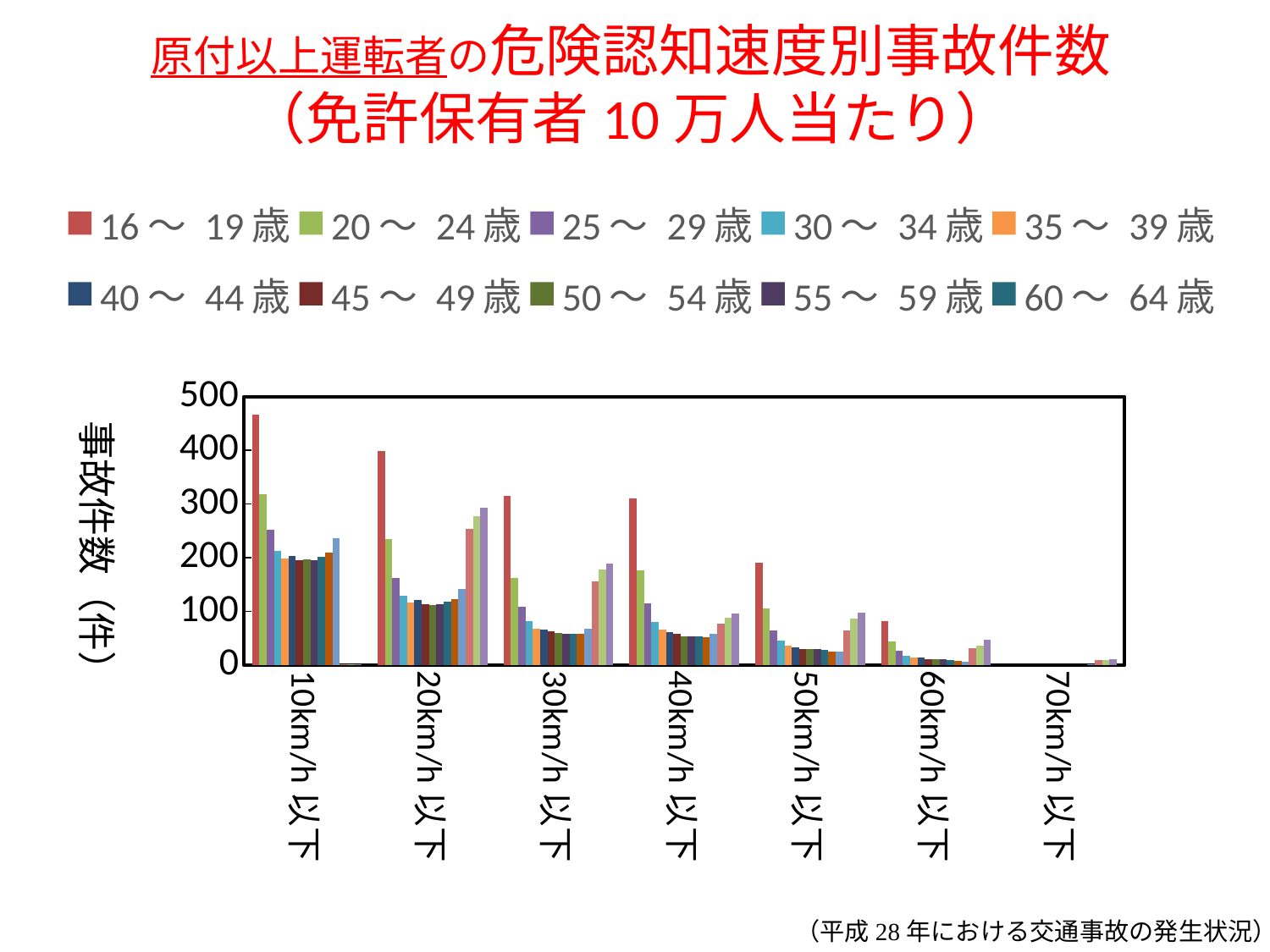
Is the value for 20～24歳 at 20km/h以下 greater or less than 200? greater Is the value for 16～19歳 at 10km/h以下 greater or less than 400? greater At 10km/h以下, which is larger: the value for 16～19歳 or for 20～24歳? 16～19歳 What kind of chart is shown on the slide? bar chart What is the label of the vertical axis? 事故件数（件） How many speed categories are shown on the x axis? 7 Is the value for 20～24歳 at 10km/h以下 greater or less than 300? greater Do the values for the 16～19歳 series rise or fall as speed increases along the x axis? fall How many age-group series does the legend list? 10 For the 16～19歳 series, which speed category has the highest value? 10km/h以下 For the 16～19歳 series, which speed category has the lowest value? 60km/h以下